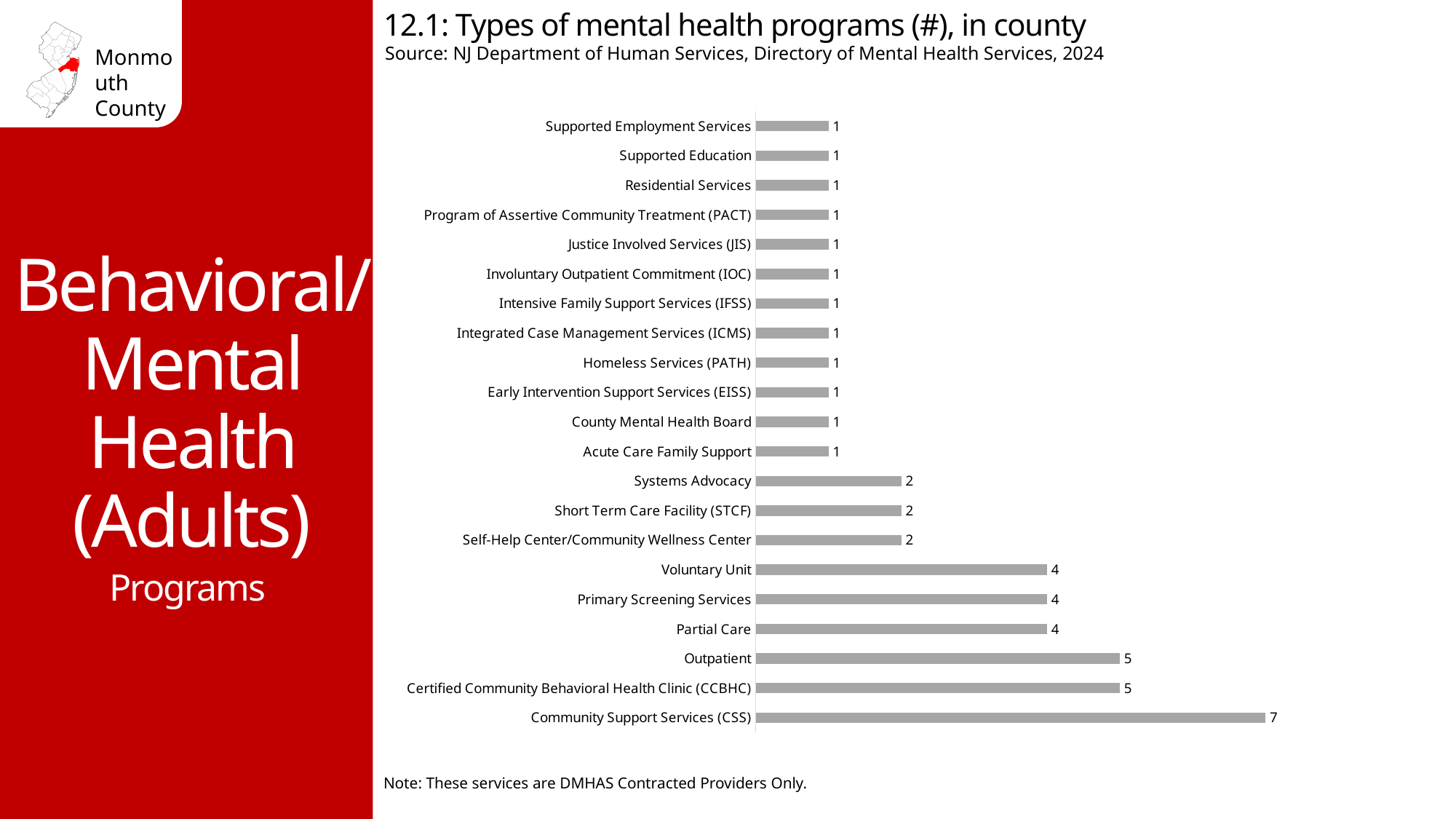
What is the difference between Community Support Services (CSS) and Outpatient? 2 How many program types are listed in the chart? 21 What is the source cited for the chart? NJ Department of Human Services, Directory of Mental Health Services, 2024 What type of chart is shown on the slide? bar chart Which is larger, Voluntary Unit or Short Term Care Facility (STCF)? Voluntary Unit How many Community Support Services (CSS) programs are there? 7 What is the value for Outpatient? 5 What is the value for Certified Community Behavioral Health Clinic (CCBHC)? 5 Which program type has the highest number of programs? Community Support Services (CSS) What is the value for Systems Advocacy? 2 What is the value for Homeless Services (PATH)? 1 What is the value for Partial Care? 4